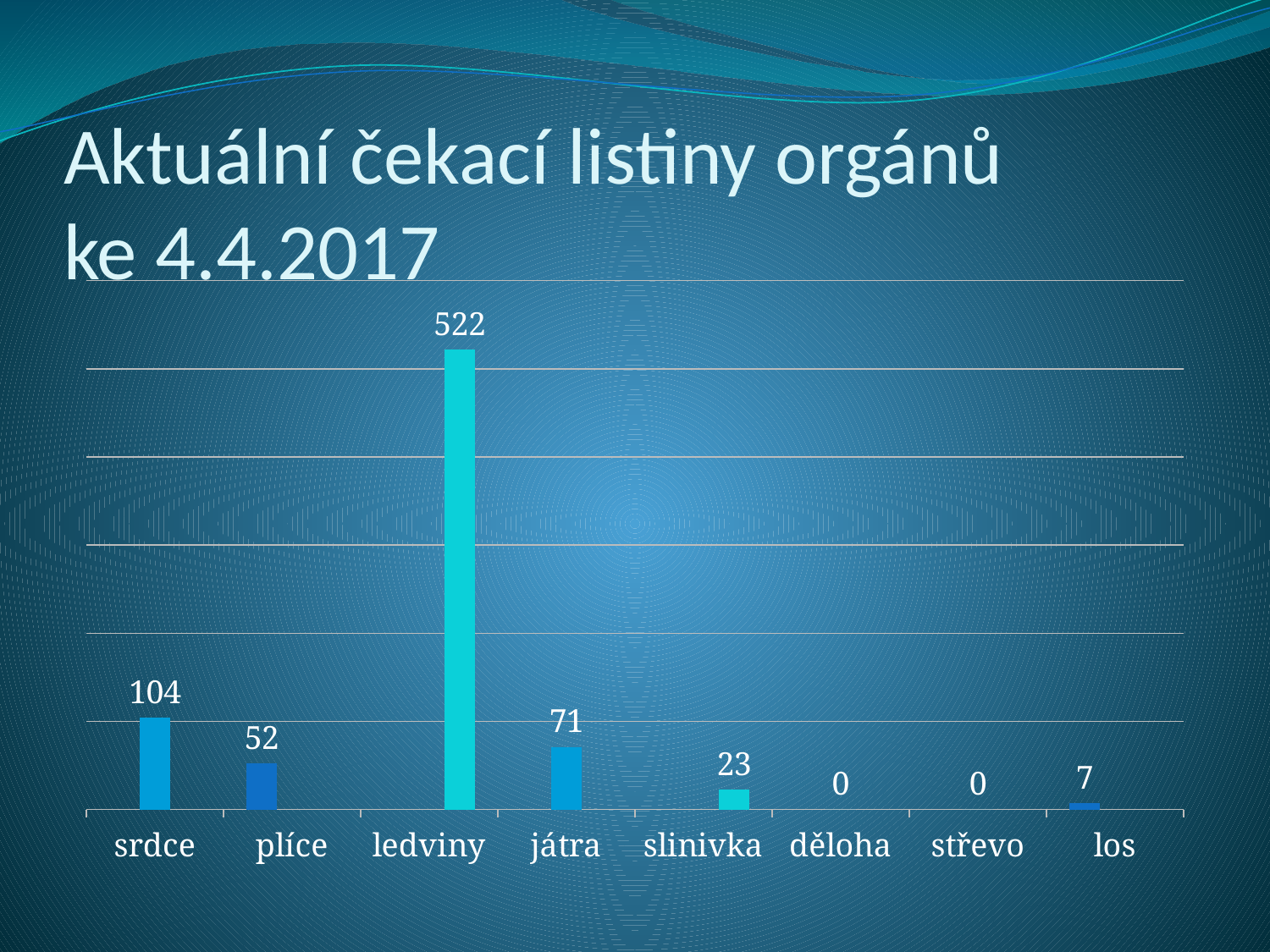
Which categories have a value of 0? děloha and střevo What is the value for los? 7 What is the difference between the values for srdce and plíce? 52 How many categories are shown on the x axis? 8 Which category has the highest value? ledviny What is the value for srdce? 104 What kind of chart is shown on the slide? bar chart Which is larger, the value for játra or the value for plíce? játra What is the value for slinivka? 23 What is the title of the slide? Aktuální čekací listiny orgánů ke 4.4.2017 What is the difference between the values for ledviny and játra? 451 What is the value for ledviny? 522